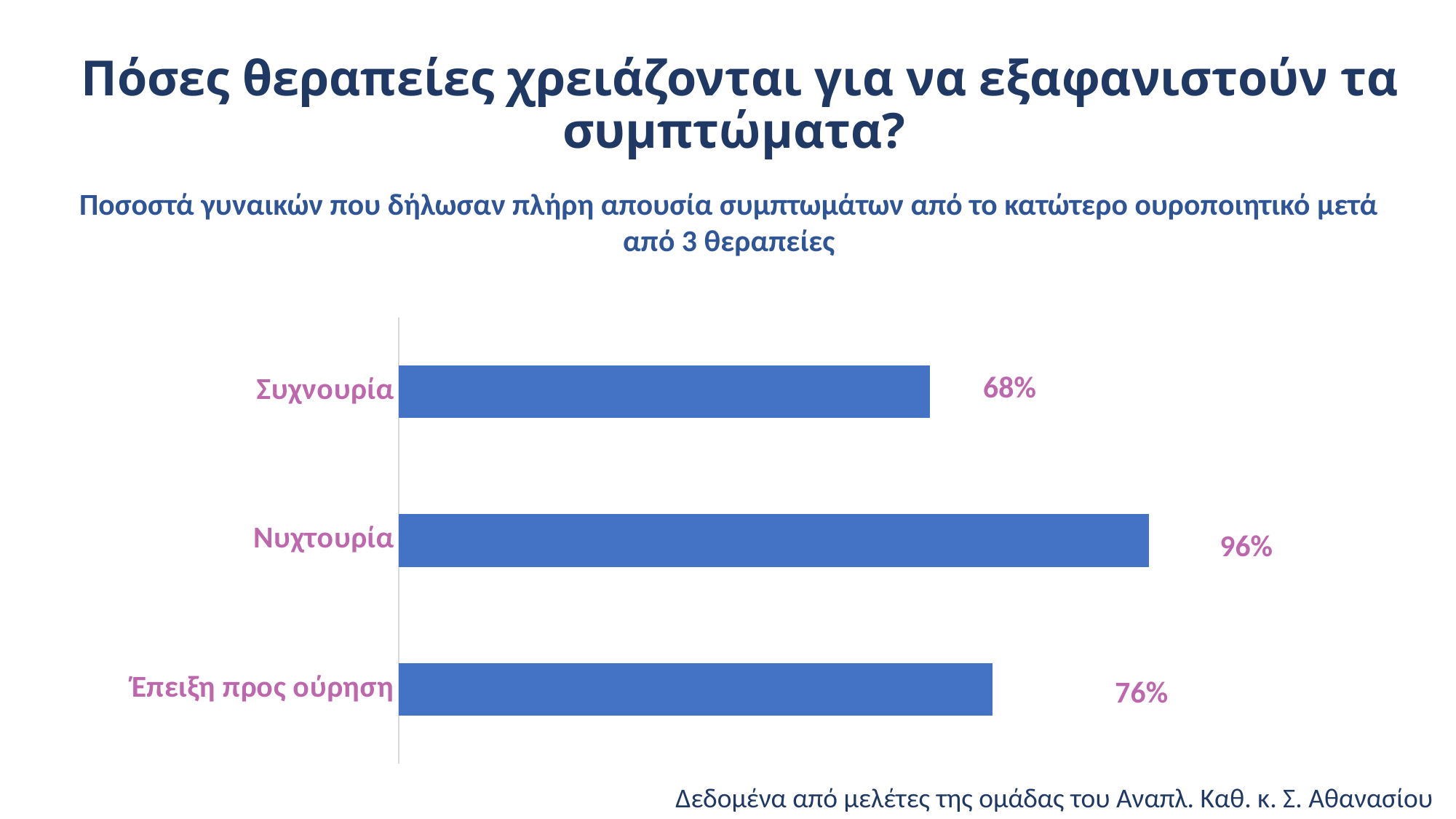
Which category has the lowest value? Συχνουρία What kind of chart is shown on the slide? Bar chart How many categories are shown in the chart? 3 What is the difference between the values for Έπειξη προς ούρηση and Συχνουρία? 8% Which is larger, the value for Νυχτουρία or the value for Έπειξη προς ούρηση? Νυχτουρία Which is larger, the value for Έπειξη προς ούρηση or the value for Συχνουρία? Έπειξη προς ούρηση What is the value for Συχνουρία? 68% What is the title of the slide? Πόσες θεραπείες χρειάζονται για να εξαφανιστούν τα συμπτώματα? Which category has the highest value? Νυχτουρία What is the difference between the values for Νυχτουρία and Συχνουρία? 28% What is the value for Νυχτουρία? 96% What is the value for Έπειξη προς ούρηση? 76%